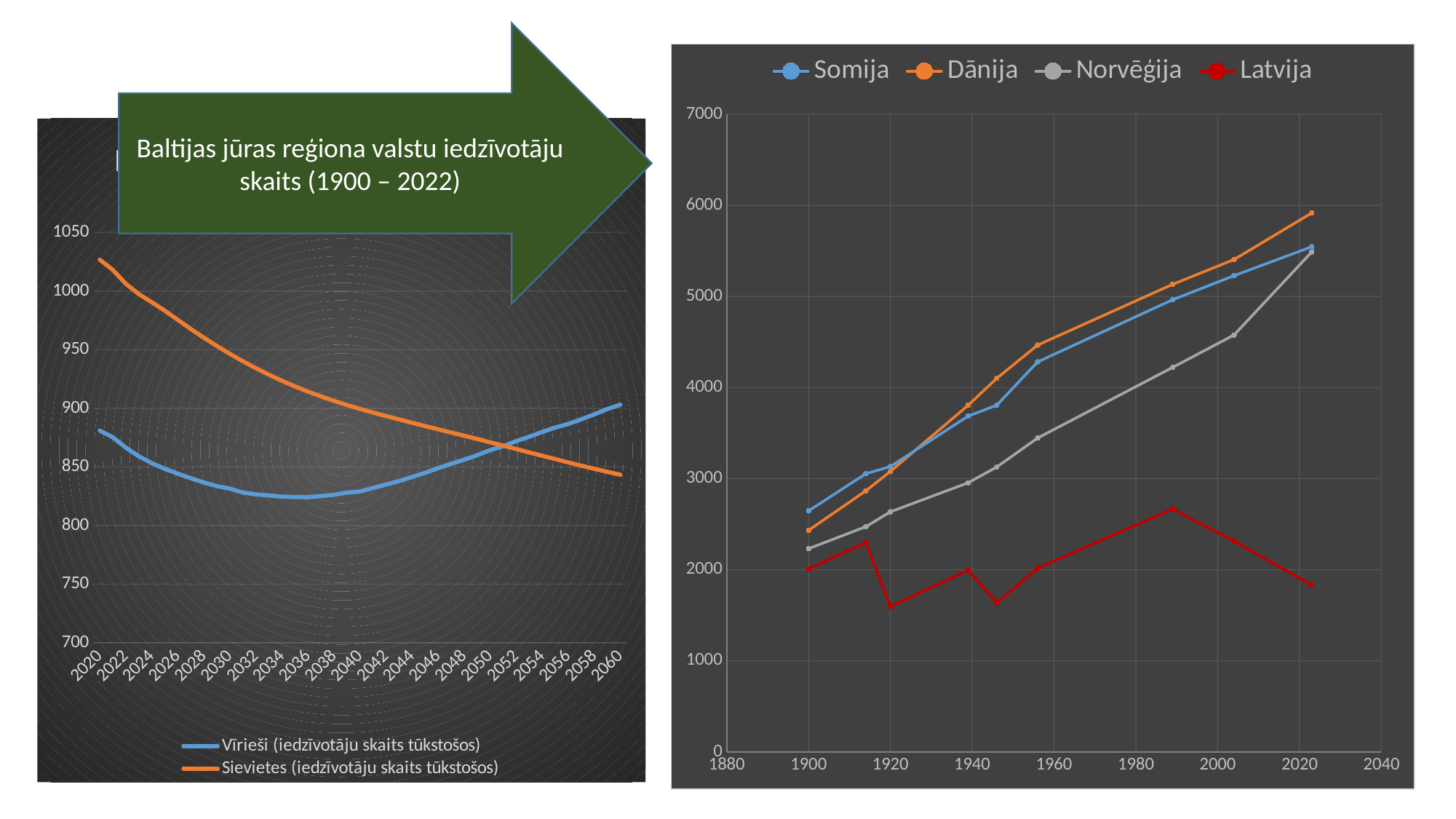
In the left-hand chart, is the value for Sievietes at 2020 greater or less than 1000? greater How many series does the legend of the right-hand chart list? 4 In the right-hand chart, does the Latvija line rise or fall between 1990 and 2020? falls How many series does the legend of the left-hand chart (Vīrieši / Sievietes) list? 2 In the left-hand chart, does the Sievietes line rise or fall from 2020 to 2060? falls In the right-hand chart, which series has the lowest value at 2020? Latvija In the right-hand chart, is the value for Dānija at 2020 greater or less than 5000? greater In the right-hand chart, is the value for Latvija at 2020 greater or less than 2000? less What kind of chart is the right-hand chart with the Somija, Dānija, Norvēģija and Latvija series? line chart In the left-hand chart, which series is larger at 2060, Vīrieši or Sievietes? Vīrieši In the right-hand chart, which series has the highest value at 2020? Dānija